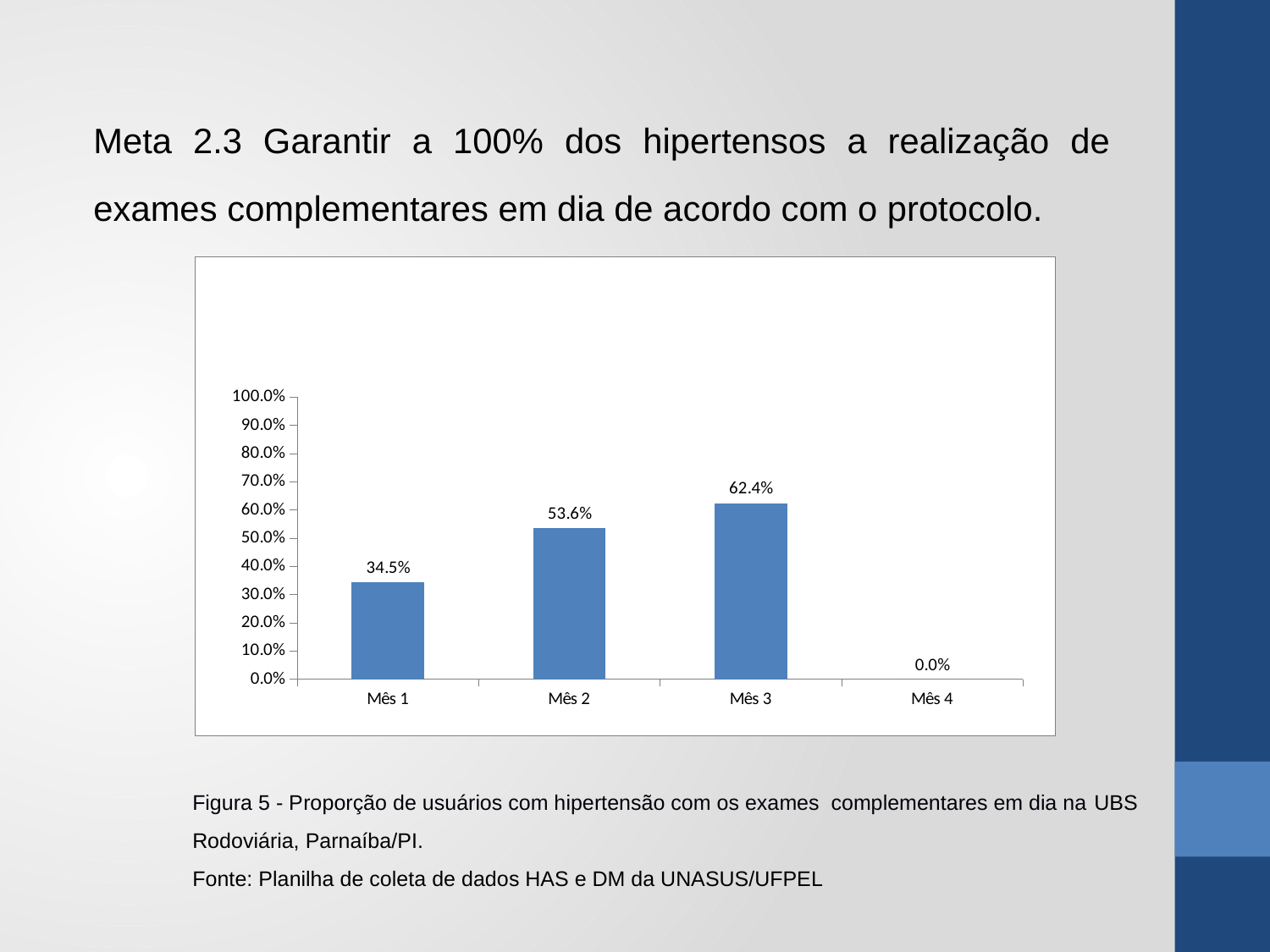
What is the value for Mês 1? 34.5% Is the value for Mês 2 greater or less than 50.0%? greater Which month has the highest value? Mês 3 How many months are shown on the x axis? 4 What is the difference between the values for Mês 2 and Mês 1? 19.1% What is the value for Mês 3? 62.4% What is the value for Mês 4? 0.0% Which month has the lowest value? Mês 4 Which is larger, the value for Mês 2 or the value for Mês 3? Mês 3 What kind of chart is shown on the slide? bar chart What is the value for Mês 2? 53.6% What is the difference between the values for Mês 3 and Mês 1? 27.9%